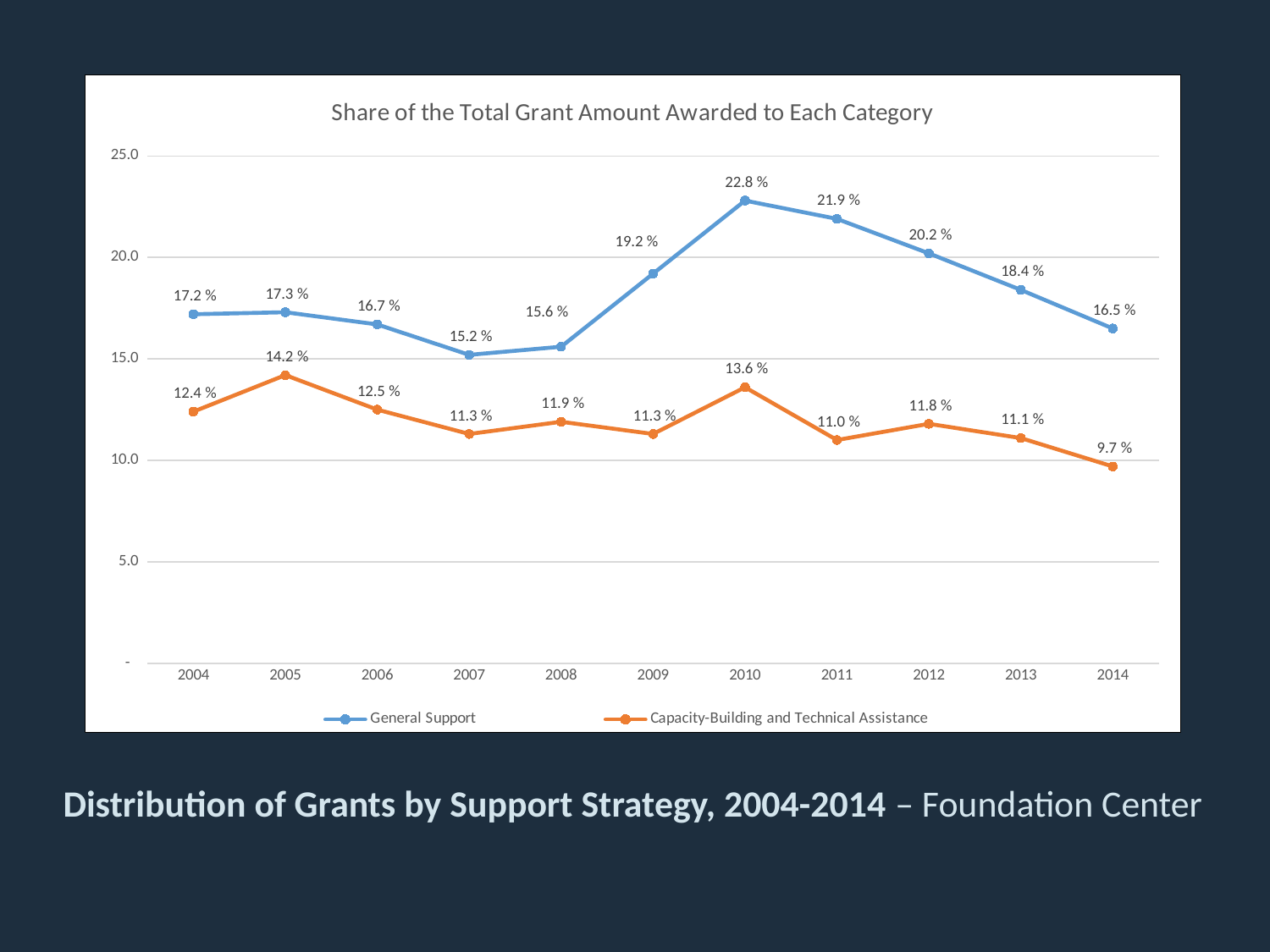
How many years are shown on the x axis? 11 What is the Capacity-Building and Technical Assistance value for 2014? 9.7 % In which year is the General Support share highest? 2010 Which series has the larger value in 2007, General Support or Capacity-Building and Technical Assistance? General Support Does the General Support series rise or fall from 2010 to 2014? Fall What is the difference between the General Support and Capacity-Building and Technical Assistance values in 2010? 9.2 % In which year is the Capacity-Building and Technical Assistance share lowest? 2014 How many series does the legend list? 2 What is the Capacity-Building and Technical Assistance value for 2005? 14.2 % Is the General Support value for 2009 greater or less than 20.0? less What is the General Support value for 2010? 22.8 % What kind of chart is shown? Line chart